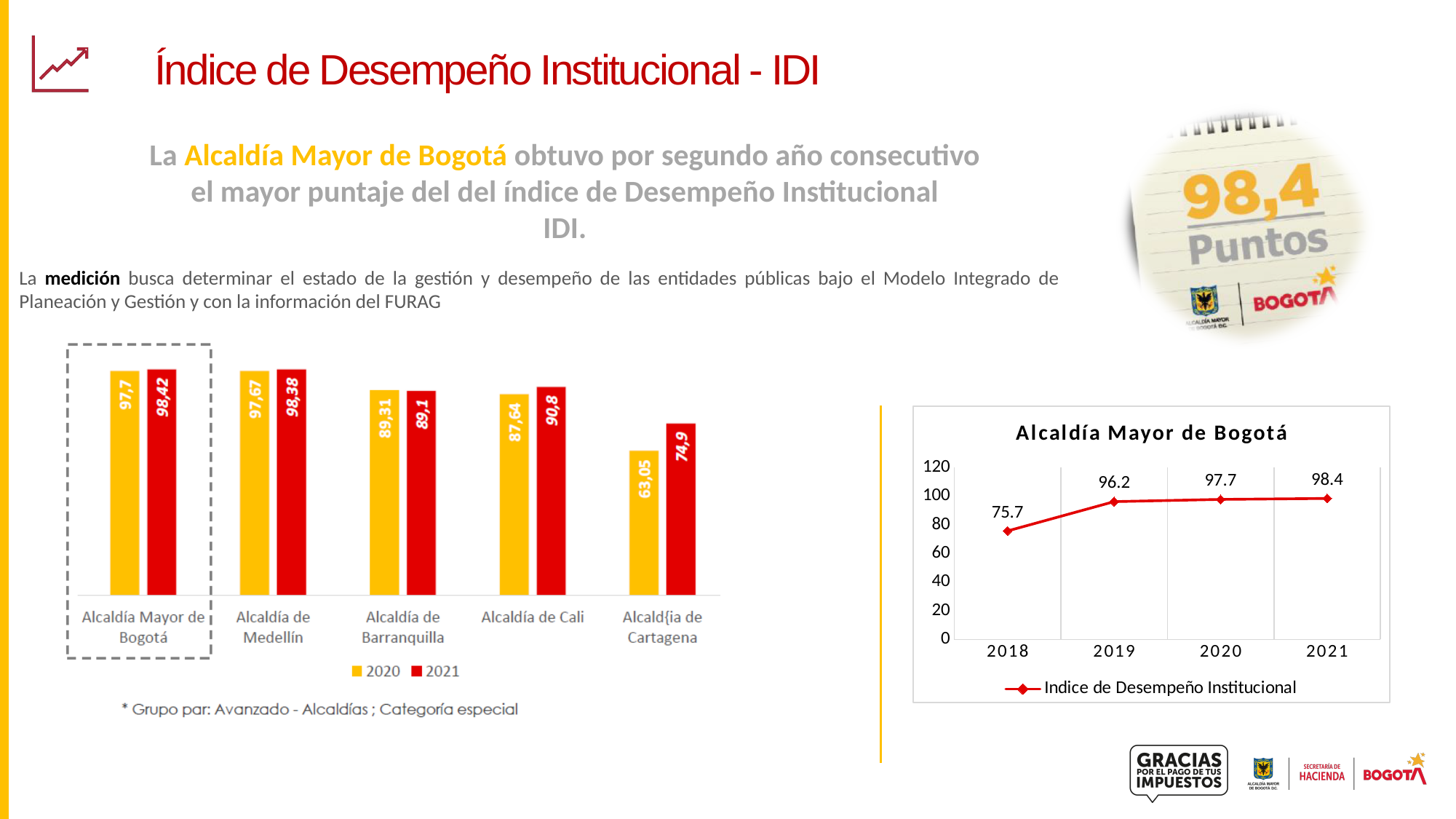
In the chart titled 'Alcaldía Mayor de Bogotá', what is the difference between the 2021 and 2018 values? 22.7 In the chart titled 'Alcaldía Mayor de Bogotá', what was the value in 2018? 75.7 In the chart titled 'Alcaldía Mayor de Bogotá', what kind of chart is shown? Line chart In the bar chart on the left, how many alcaldías are shown? 5 In the bar chart on the left, what was the 2021 value for Alcaldía de Cali? 90,8 In the bar chart on the left, how many series does the legend list? 2 In the chart titled 'Alcaldía Mayor de Bogotá', do the values rise or fall from 2018 to 2021? Rise In the bar chart on the left, which is larger for Alcaldía de Barranquilla: the 2020 value or the 2021 value? 2020 In the bar chart on the left, what was the 2021 value for Alcaldía Mayor de Bogotá? 98,42 In the bar chart on the left, what was the 2020 value for Alcaldía de Cartagena? 63,05 In the bar chart on the left, what is the difference between the 2021 and 2020 values for Alcaldía de Cartagena? 11,85 In the bar chart on the left, which alcaldía had the lowest 2021 value? Alcaldía de Cartagena